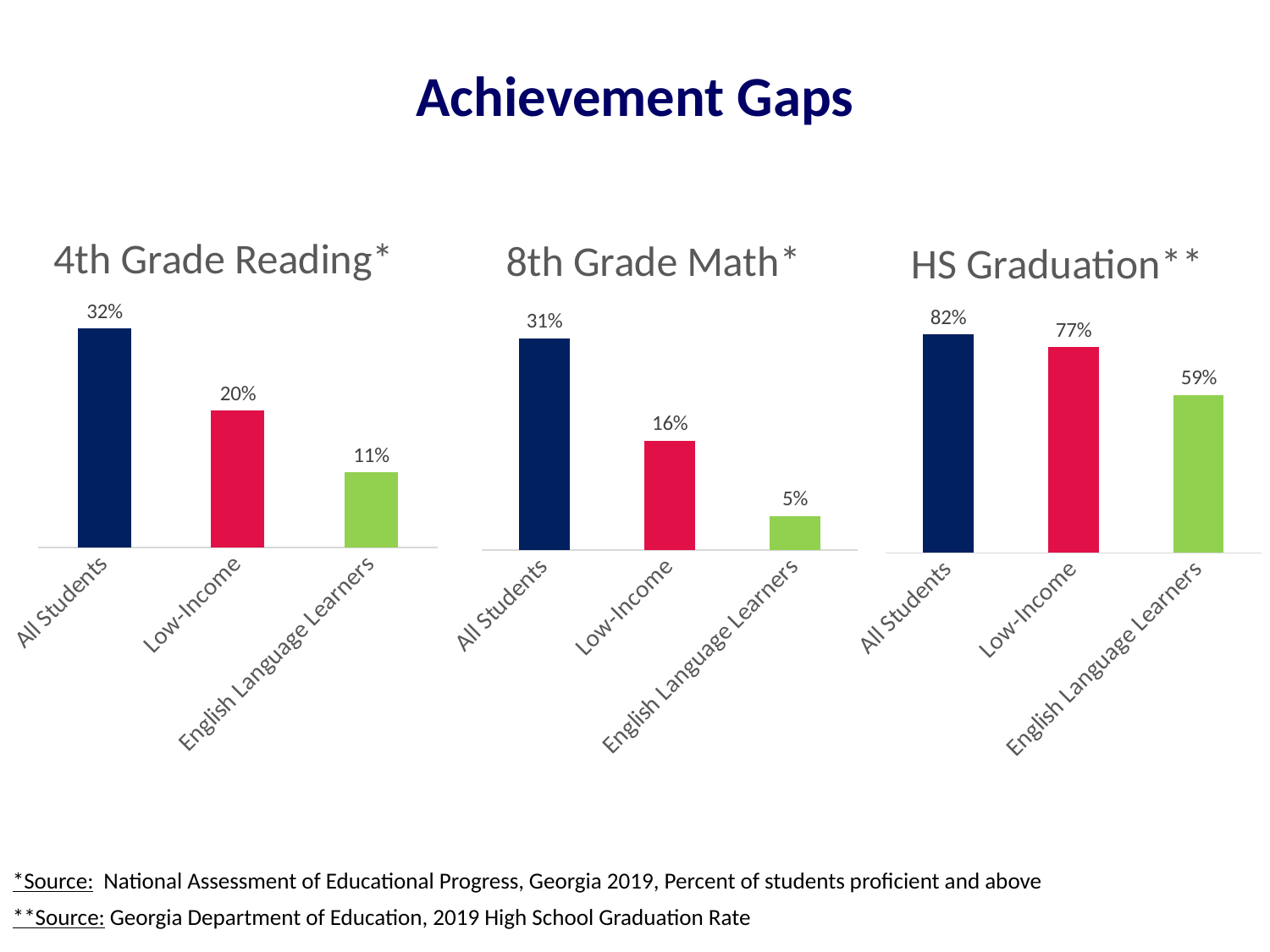
In the 8th Grade Math chart, which category has the highest value? All Students In the 4th Grade Reading chart, what is the value for Low-Income students? 20% In the 4th Grade Reading chart, do the values rise or fall from left to right? Fall How many categories are shown in the 8th Grade Math chart? 3 What type of chart is the HS Graduation chart? Bar chart In the HS Graduation chart, what is the value for All Students? 82% In the HS Graduation chart, what is the difference between All Students and Low-Income? 5% In the 4th Grade Reading chart, what is the difference between All Students and English Language Learners? 21% How many charts are shown on the slide? 3 Which is larger: the Low-Income value in the 4th Grade Reading chart or the Low-Income value in the 8th Grade Math chart? 4th Grade Reading In the 8th Grade Math chart, what is the value for English Language Learners? 5% In the HS Graduation chart, which category has the lowest value? English Language Learners